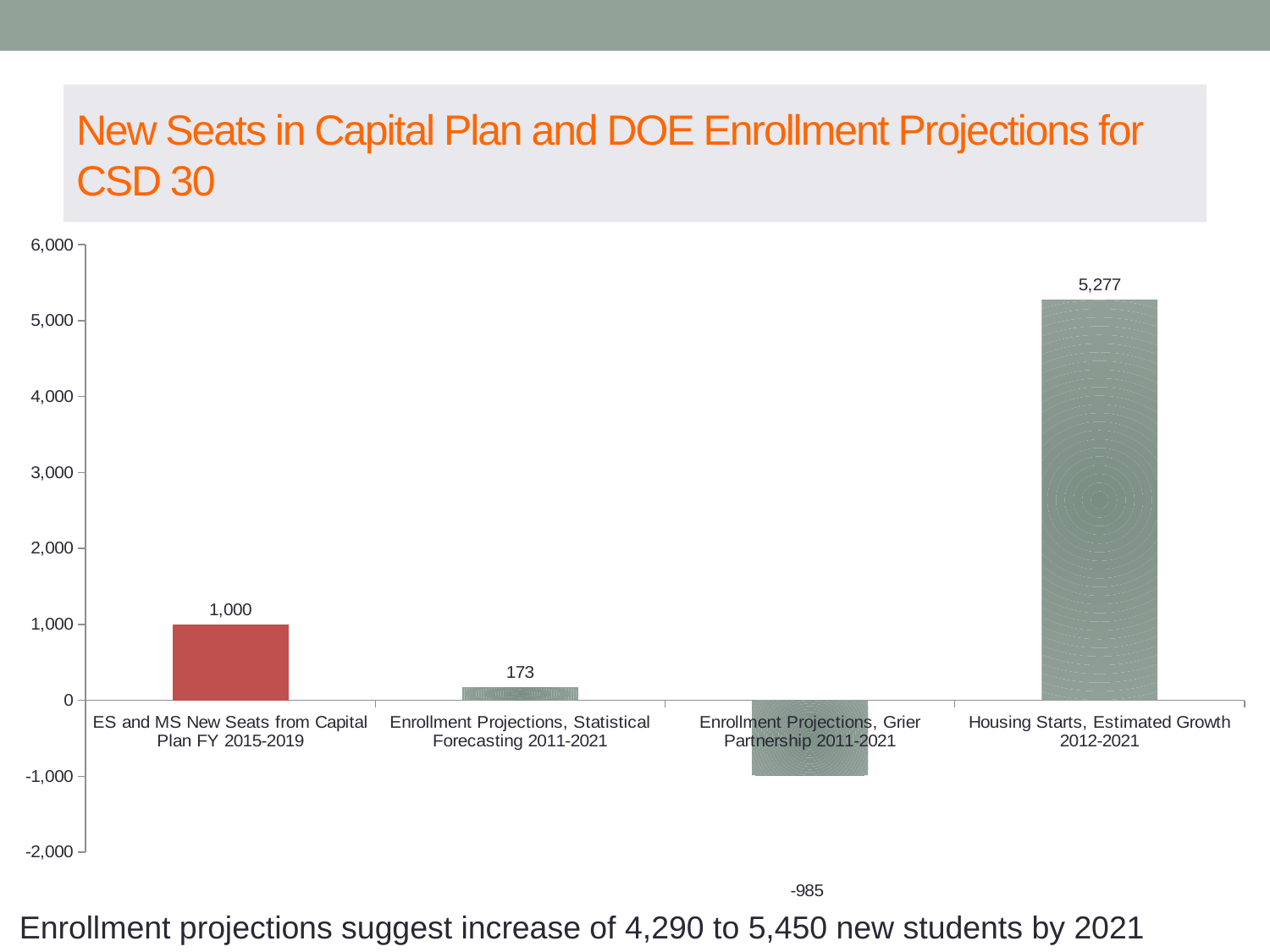
What is the value for Enrollment Projections, Statistical Forecasting 2011-2021? 173 Which category has the lowest value? Enrollment Projections, Grier Partnership 2011-2021 How many categories are shown in the chart? 4 Which category has the highest value? Housing Starts, Estimated Growth 2012-2021 What is the value for Enrollment Projections, Grier Partnership 2011-2021? -985 What is the title of the chart? New Seats in Capital Plan and DOE Enrollment Projections for CSD 30 What is the value for Housing Starts, Estimated Growth 2012-2021? 5,277 What kind of chart is shown on the slide? bar chart Is the value for Housing Starts, Estimated Growth 2012-2021 greater or less than 5,000? greater What is the difference between the value for Housing Starts, Estimated Growth 2012-2021 and the value for ES and MS New Seats from Capital Plan FY 2015-2019? 4,277 Which is larger: the value for ES and MS New Seats from Capital Plan FY 2015-2019 or the value for Enrollment Projections, Statistical Forecasting 2011-2021? ES and MS New Seats from Capital Plan FY 2015-2019 What is the value for ES and MS New Seats from Capital Plan FY 2015-2019? 1,000